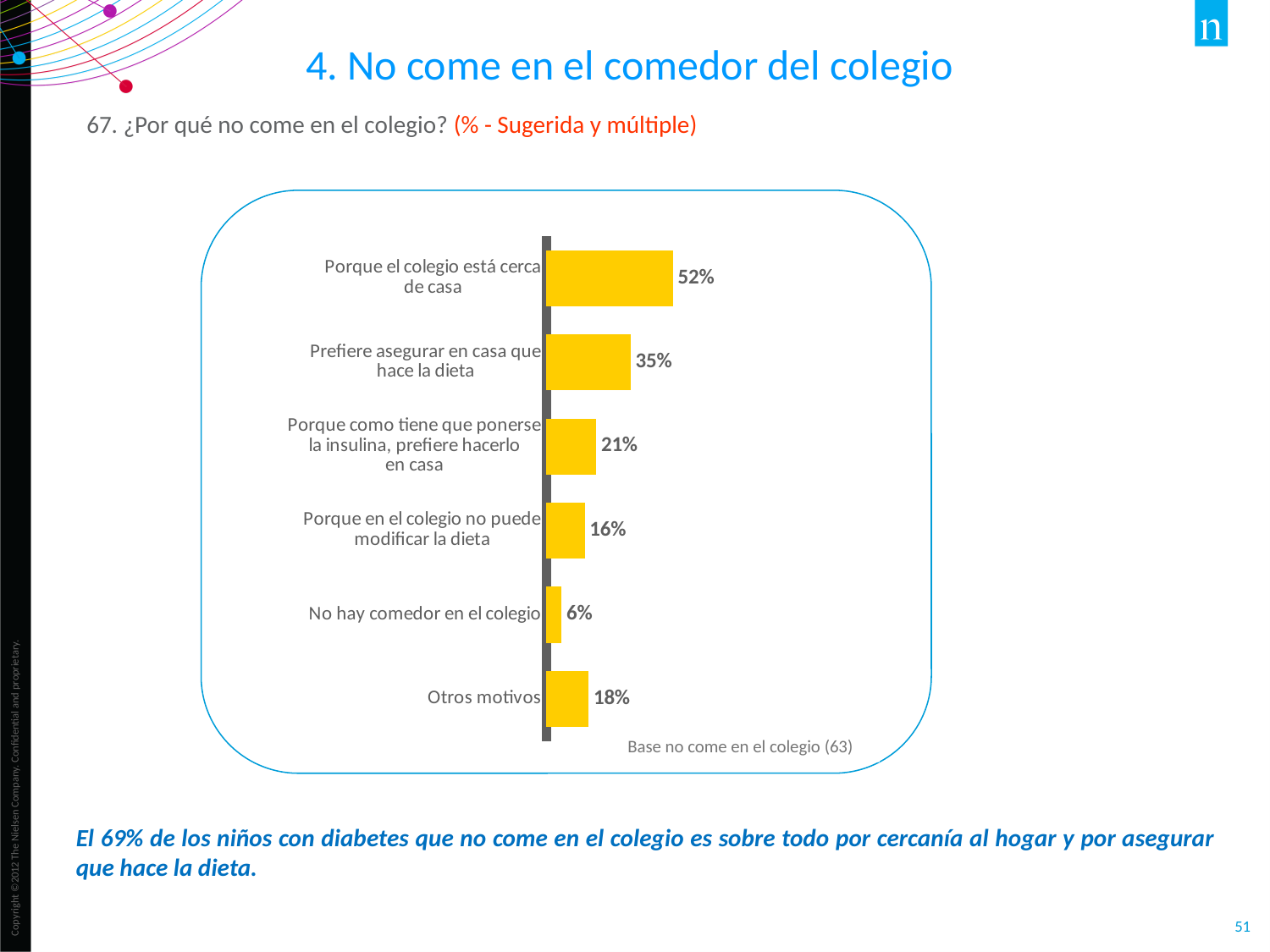
What kind of chart is shown on the slide? Bar chart Which reason has the highest percentage? Porque el colegio está cerca de casa What percentage is shown for "Porque el colegio está cerca de casa"? 52% How many reasons (categories) are shown in the chart? 6 What is the difference between "Porque el colegio está cerca de casa" and "Prefiere asegurar en casa que hace la dieta"? 17% Which is larger: "Porque en el colegio no puede modificar la dieta" or "Otros motivos"? Otros motivos What percentage is shown for "No hay comedor en el colegio"? 6% What percentage is shown for "Otros motivos"? 18% What percentage is shown for "Prefiere asegurar en casa que hace la dieta"? 35% What base is stated for the chart? Base no come en el colegio (63) Which reason has the lowest percentage? No hay comedor en el colegio What is the difference between "Porque como tiene que ponerse la insulina, prefiere hacerlo en casa" and "Porque en el colegio no puede modificar la dieta"? 5%